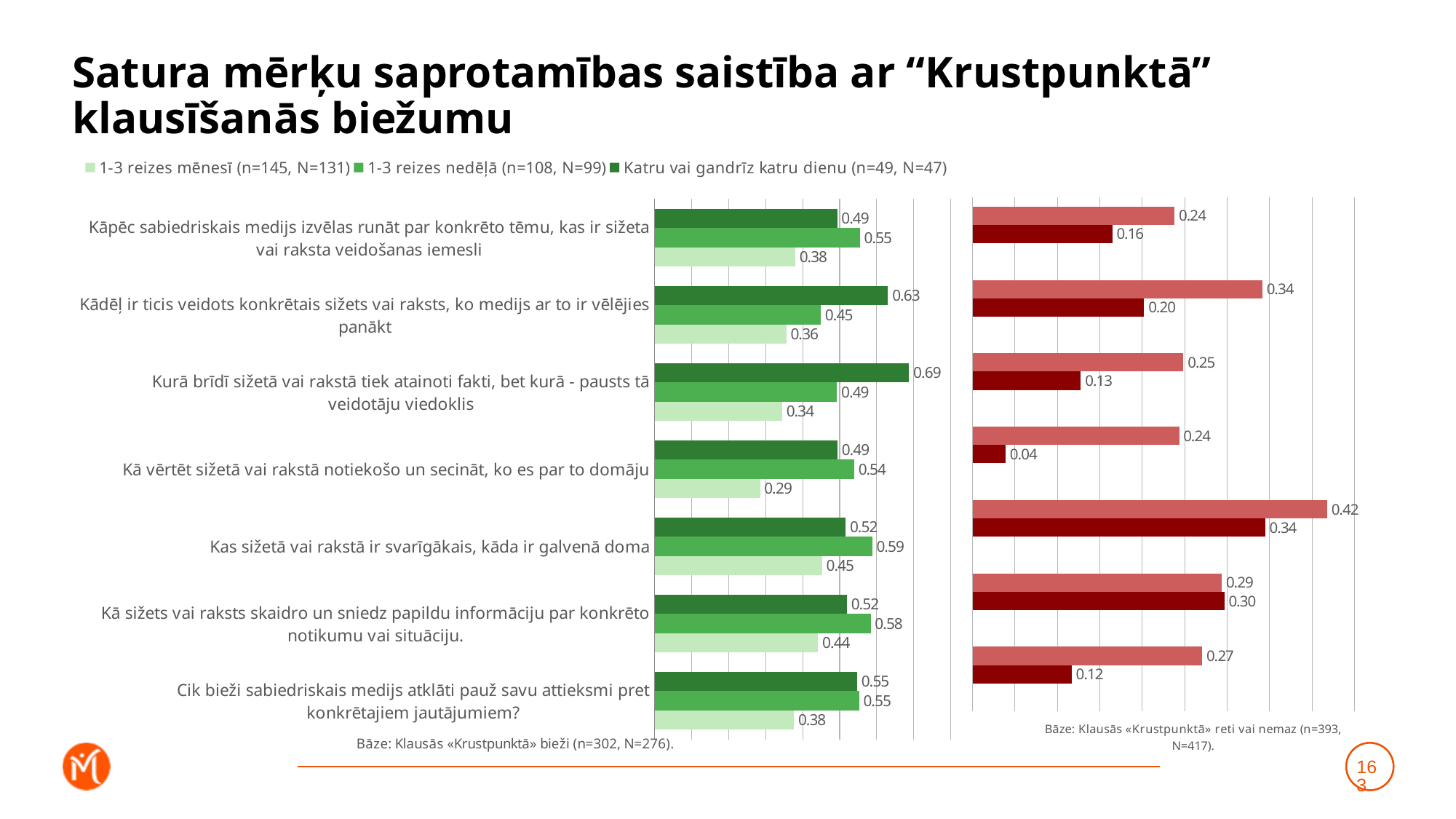
What type of chart is the green chart on the left? Bar chart What is the highest value shown in the red chart on the right? 0.42 How many categories are shown in the green chart on the left? 7 In the green chart on the left, what is the value for "1-3 reizes nedēļā" for "Kas sižetā vai rakstā ir svarīgākais, kāda ir galvenā doma"? 0.59 In the green chart on the left, which category has the lowest value for the "1-3 reizes mēnesī" series? Kā vērtēt sižetā vai rakstā notiekošo un secināt, ko es par to domāju In the green chart on the left, for "Kādēļ ir ticis veidots konkrētais sižets vai raksts, ko medijs ar to ir vēlējies panākt", what is the difference between the "Katru vai gandrīz katru dienu" value and the "1-3 reizes mēnesī" value? 0.27 In the green chart on the left, which legend series is shown in the darkest green? Katru vai gandrīz katru dienu (n=49, N=47) How many series does the legend of the green chart on the left list? 3 In the green chart on the left, what is the value for "Katru vai gandrīz katru dienu" for "Kurā brīdī sižetā vai rakstā tiek atainoti fakti, bet kurā - pausts tā veidotāju viedoklis"? 0.69 In the green chart on the left, for "Kāpēc sabiedriskais medijs izvēlas runāt par konkrēto tēmu, kas ir sižeta vai raksta veidošanas iemesli", which is larger: the "1-3 reizes nedēļā" value or the "Katru vai gandrīz katru dienu" value? 1-3 reizes nedēļā In the green chart on the left, which category has the highest value for the "Katru vai gandrīz katru dienu" series? Kurā brīdī sižetā vai rakstā tiek atainoti fakti, bet kurā - pausts tā veidotāju viedoklis In the green chart on the left, what is the value for "1-3 reizes mēnesī" for "Kā vērtēt sižetā vai rakstā notiekošo un secināt, ko es par to domāju"? 0.29